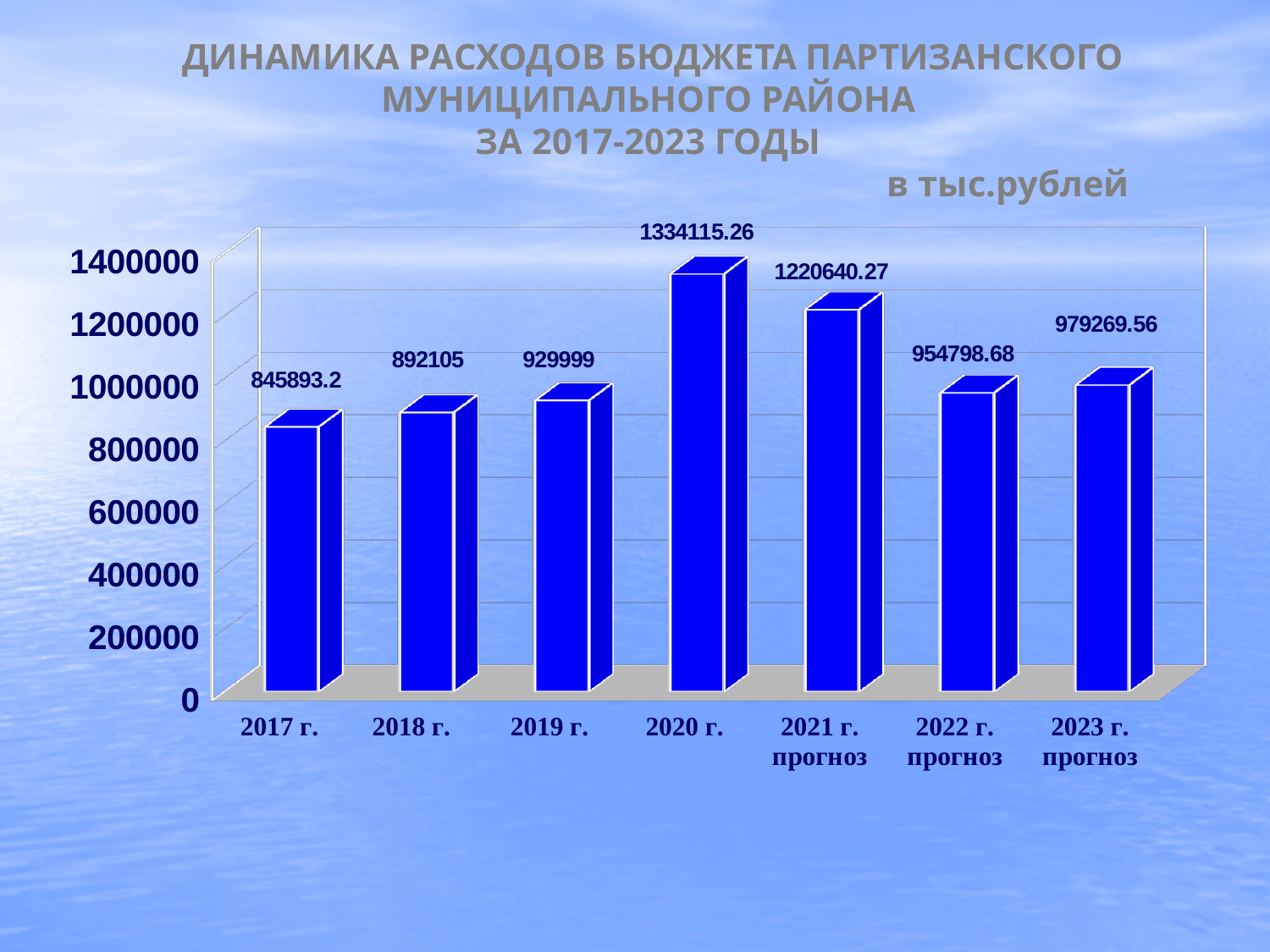
What is the difference between the values for 2020 г. and 2021 г. прогноз? 113474.99 What is the value for 2017 г.? 845893.2 Which year has the lowest value? 2017 г. Is the value for 2021 г. прогноз greater or less than 1200000? greater What is the value for 2020 г.? 1334115.26 How many years are shown on the x axis? 7 What is the difference between the values for 2018 г. and 2017 г.? 46211.8 What is the value for 2022 г. прогноз? 954798.68 Do the values rise or fall from 2017 г. to 2020 г.? rise Which year has the highest value? 2020 г. What kind of chart is this? bar chart Which is larger, the value for 2023 г. прогноз or 2022 г. прогноз? 2023 г. прогноз